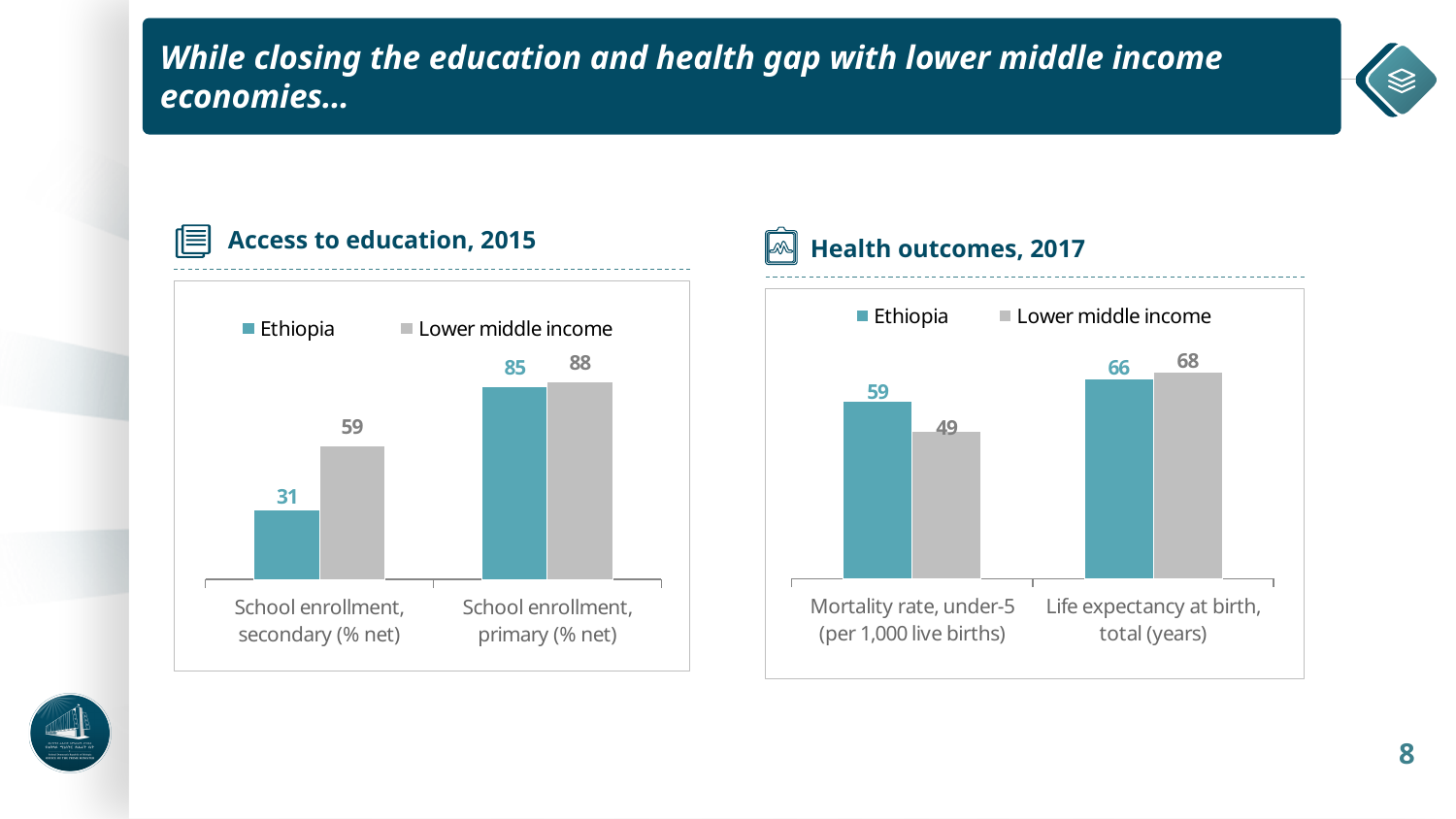
In the 'Health outcomes, 2017' chart, what is the difference between Ethiopia and Lower middle income for Mortality rate, under-5 (per 1,000 live births)? 10 In the 'Health outcomes, 2017' chart, what is the value for Lower middle income for Life expectancy at birth, total (years)? 68 In the 'Access to education, 2015' chart, what is the value for Lower middle income for School enrollment, primary (% net)? 88 In the 'Health outcomes, 2017' chart, what is the value for Ethiopia for Mortality rate, under-5 (per 1,000 live births)? 59 What kind of chart is the 'Health outcomes, 2017' chart? Bar chart How many categories are shown on the x axis of the 'Access to education, 2015' chart? 2 In the 'Access to education, 2015' chart, what is the value for Ethiopia for School enrollment, secondary (% net)? 31 In the 'Access to education, 2015' chart, which series has the highest value overall? Lower middle income In the 'Health outcomes, 2017' chart, which is larger for Mortality rate, under-5: Ethiopia or Lower middle income? Ethiopia In the 'Access to education, 2015' chart, which bar has the lowest value? Ethiopia, School enrollment, secondary (% net) How many series does the legend of the 'Health outcomes, 2017' chart list? 2 In the 'Access to education, 2015' chart, what is the difference between Lower middle income and Ethiopia for School enrollment, secondary (% net)? 28